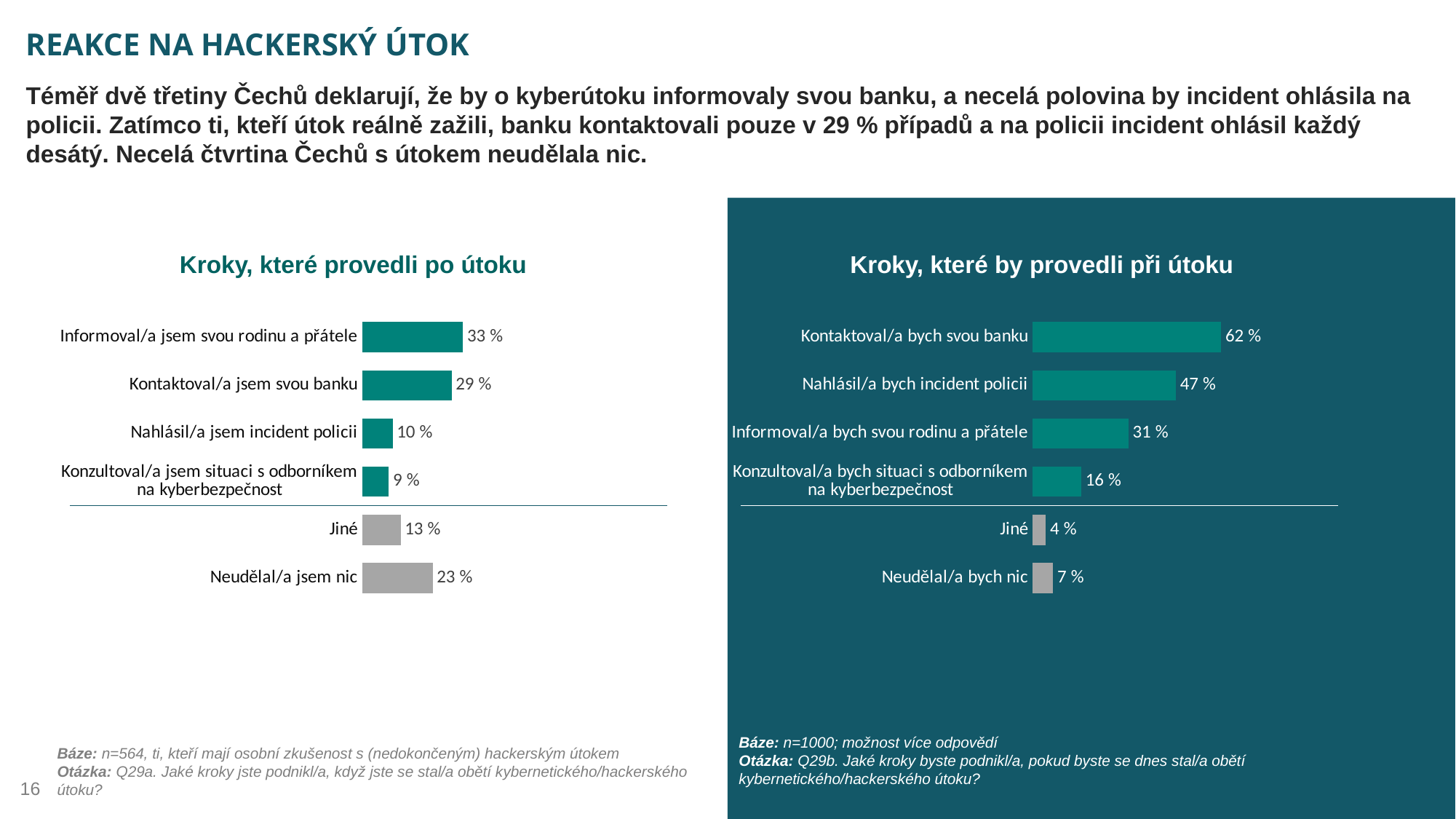
In the chart 'Kroky, které provedli po útoku', what is the difference between 'Neudělal/a jsem nic' and 'Jiné'? 10 % In the chart 'Kroky, které by provedli při útoku', which is larger: 'Informoval/a bych svou rodinu a přátele' or 'Konzultoval/a bych situaci s odborníkem na kyberbezpečnost'? Informoval/a bych svou rodinu a přátele In the chart 'Kroky, které provedli po útoku', which category has the lowest value? Konzultoval/a jsem situaci s odborníkem na kyberbezpečnost In the chart 'Kroky, které by provedli při útoku', what is the difference between 'Kontaktoval/a bych svou banku' and 'Nahlásil/a bych incident policii'? 15 % What kind of chart is 'Kroky, které provedli po útoku'? Bar chart How many categories are shown in the chart 'Kroky, které by provedli při útoku'? 6 In the chart 'Kroky, které by provedli při útoku', which category has the lowest value? Jiné In the chart 'Kroky, které provedli po útoku', which is larger: 'Nahlásil/a jsem incident policii' or 'Neudělal/a jsem nic'? Neudělal/a jsem nic In the chart 'Kroky, které by provedli při útoku', what is the value for 'Nahlásil/a bych incident policii'? 47 % In the chart 'Kroky, které provedli po útoku', what colour are the bars for 'Jiné' and 'Neudělal/a jsem nic'? Grey In the chart 'Kroky, které provedli po útoku', what is the value for 'Kontaktoval/a jsem svou banku'? 29 % In the chart 'Kroky, které provedli po útoku', which category has the highest value? Informoval/a jsem svou rodinu a přátele